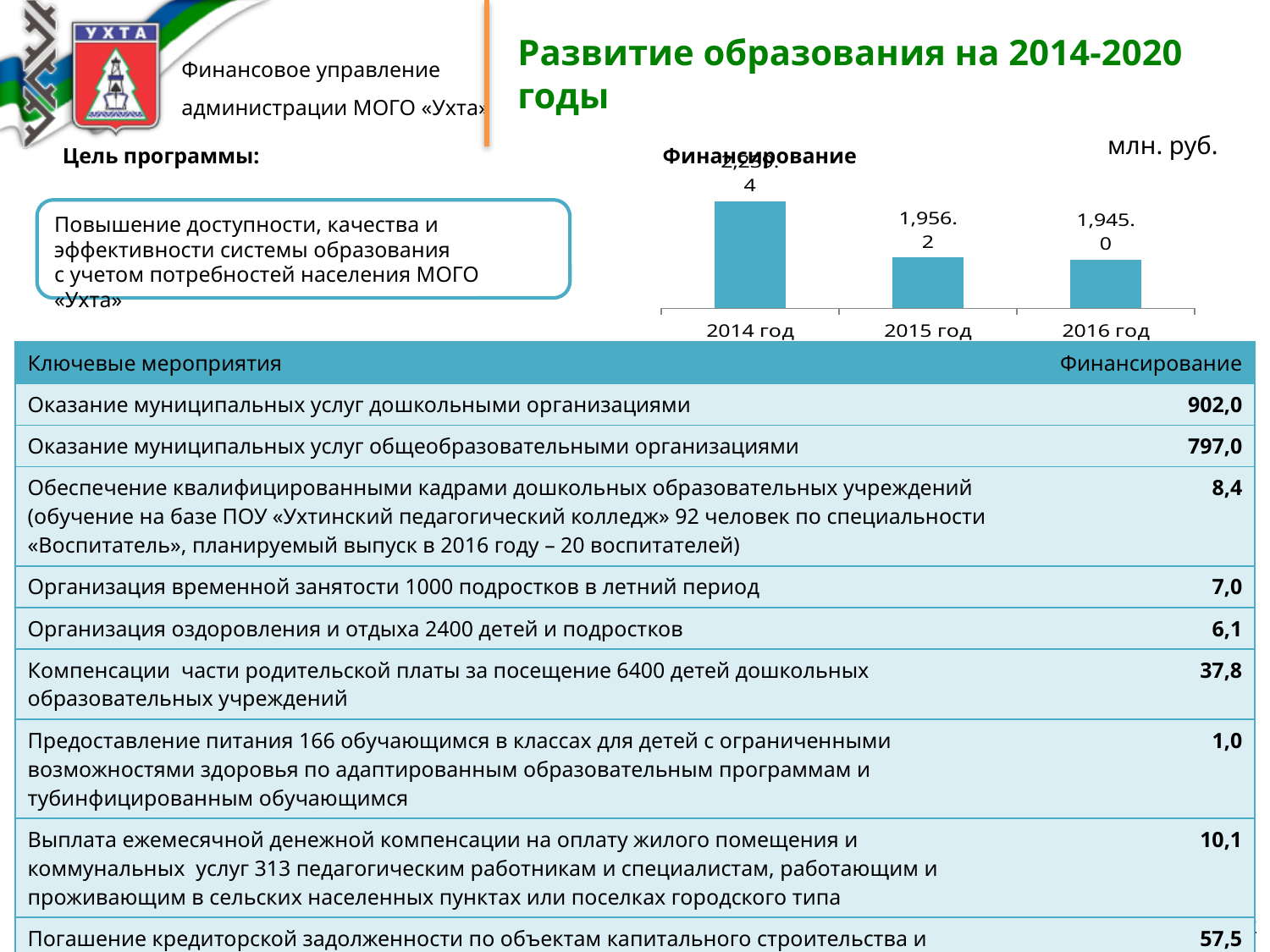
Which year has the highest value in the chart? 2014 год What is the title of the chart? Финансирование What is the value for 2016 год in the chart? 1,945.0 What kind of chart is shown on the slide? bar chart What is the value for 2015 год in the chart? 1,956.2 What is the difference between the values for 2015 год and 2016 год? 11.2 Which is larger, the value for 2015 год or for 2016 год? 2015 год How many years are plotted in the chart? 3 In what units are the chart values given, according to the label next to the chart? млн. руб. Which year has the lowest value in the chart? 2016 год Do the values rise or fall from 2014 год to 2016 год? fall